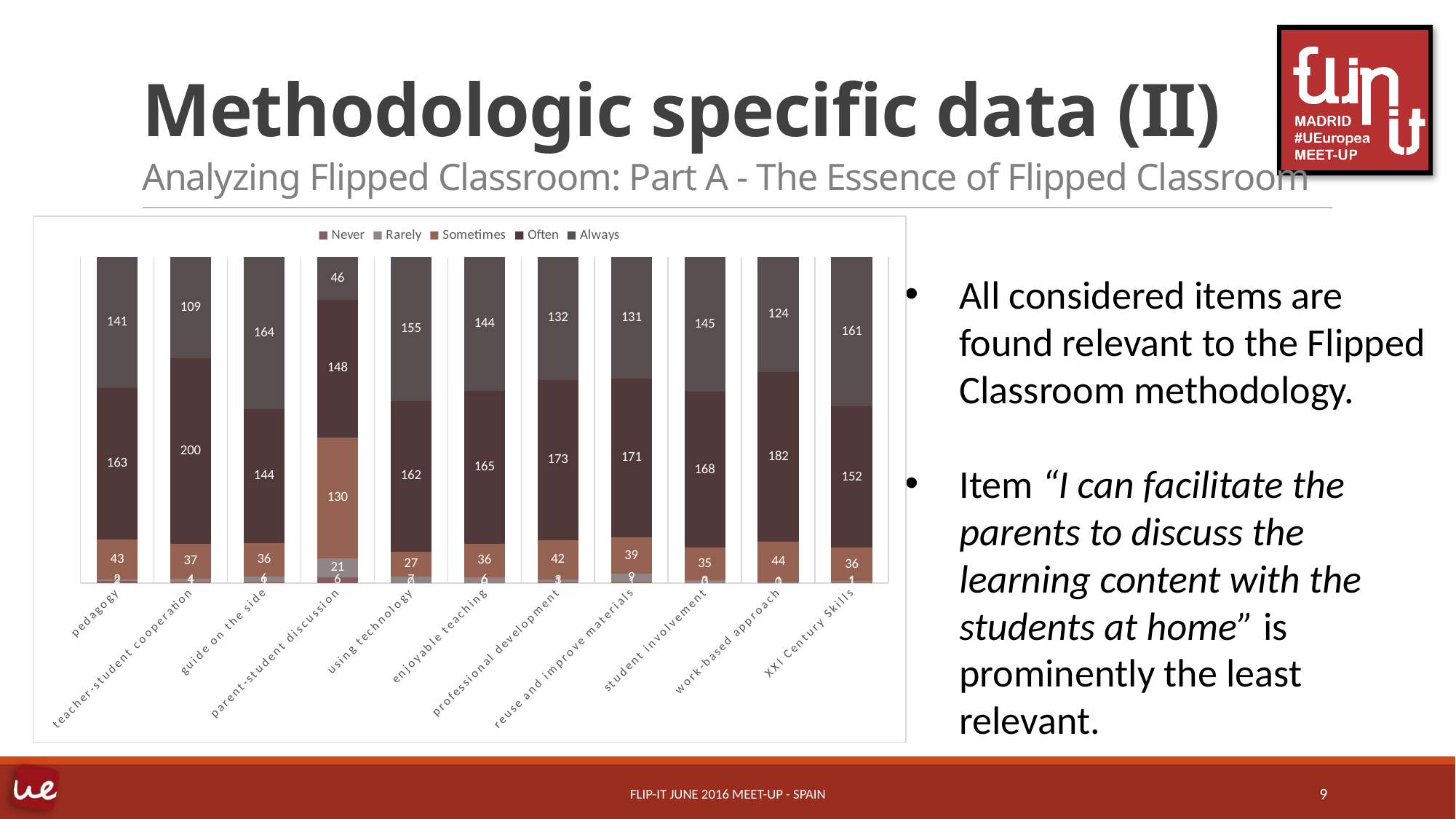
Which series is listed first in the legend? Never What kind of chart is shown on the slide? stacked bar chart What is the 'Always' value for XXI Century Skills? 161 What is the difference between the 'Often' values for work-based approach and pedagogy? 19 Which is larger, the 'Always' value for guide on the side or the 'Always' value for using technology? guide on the side What is the 'Often' value for teacher-student cooperation? 200 How many series does the legend list? 5 How many categories are shown along the x axis? 11 Which category has the lowest 'Always' value? parent-student discussion What is the 'Sometimes' value for parent-student discussion? 130 What is the difference between the 'Always' and 'Often' values for parent-student discussion? 102 Which category has the highest 'Often' value? teacher-student cooperation